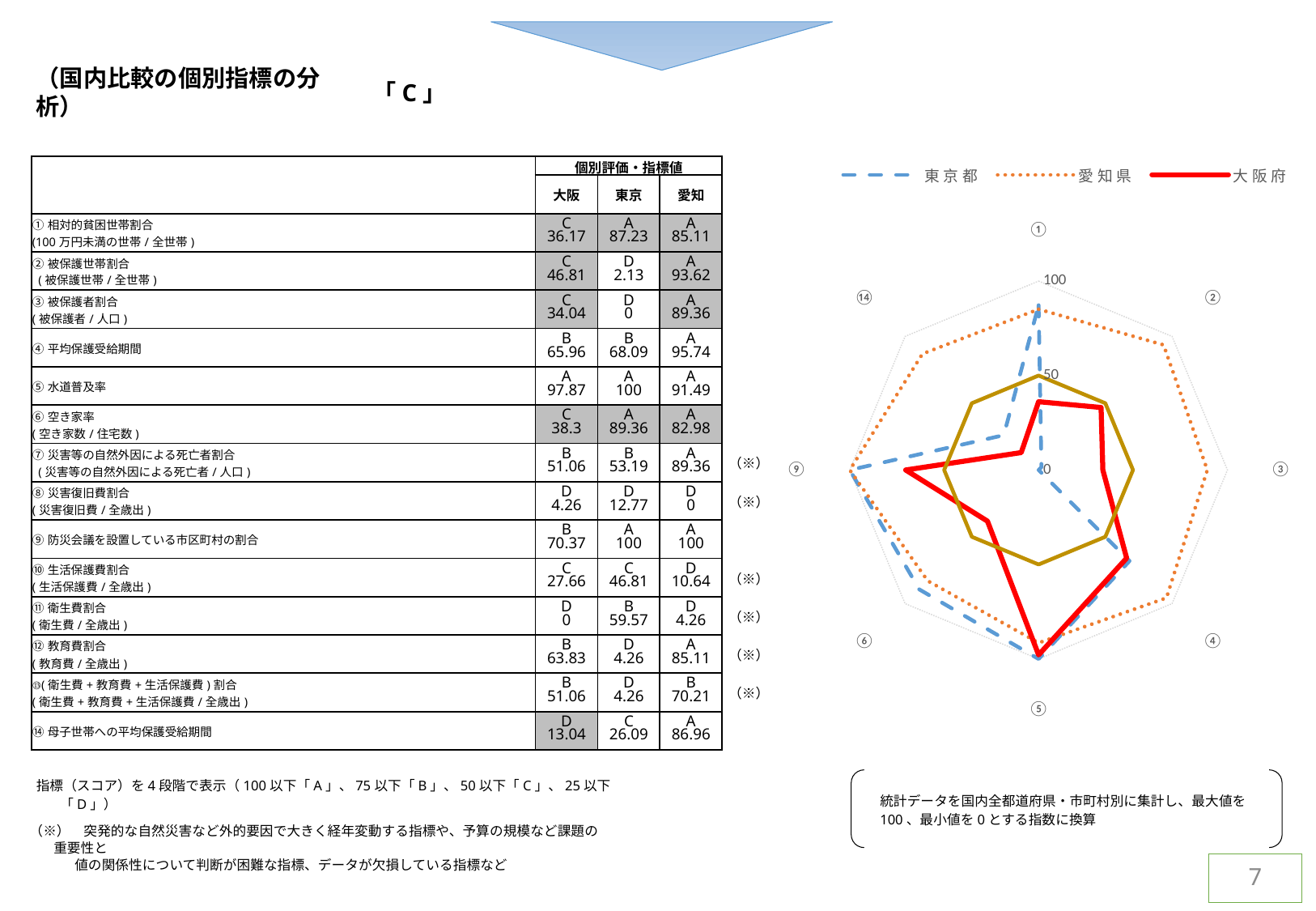
In the radar chart, which series has the highest value on axis ③? 愛知県 In the radar chart, is the value for 東京都 on axis ① greater or less than 50? greater In the radar chart, which is larger on axis ⑥: the value for 東京都 or the value for 大阪府? 東京都 Which series in the radar chart legend is drawn as a solid red line? 大阪府 What kind of chart is shown on the right side of the slide? radar chart In the radar chart, which series has the lowest value on axis ②? 東京都 In the radar chart, is the value for 東京都 on axis ③ greater or less than 50? less In the radar chart, is the value for 大阪府 on axis ⑭ greater or less than 50? less How many series does the legend of the radar chart list? 3 In the radar chart, which is larger on axis ⑨: the value for 東京都 or the value for 大阪府? 東京都 Which series in the radar chart legend is drawn as a blue dashed line? 東京都